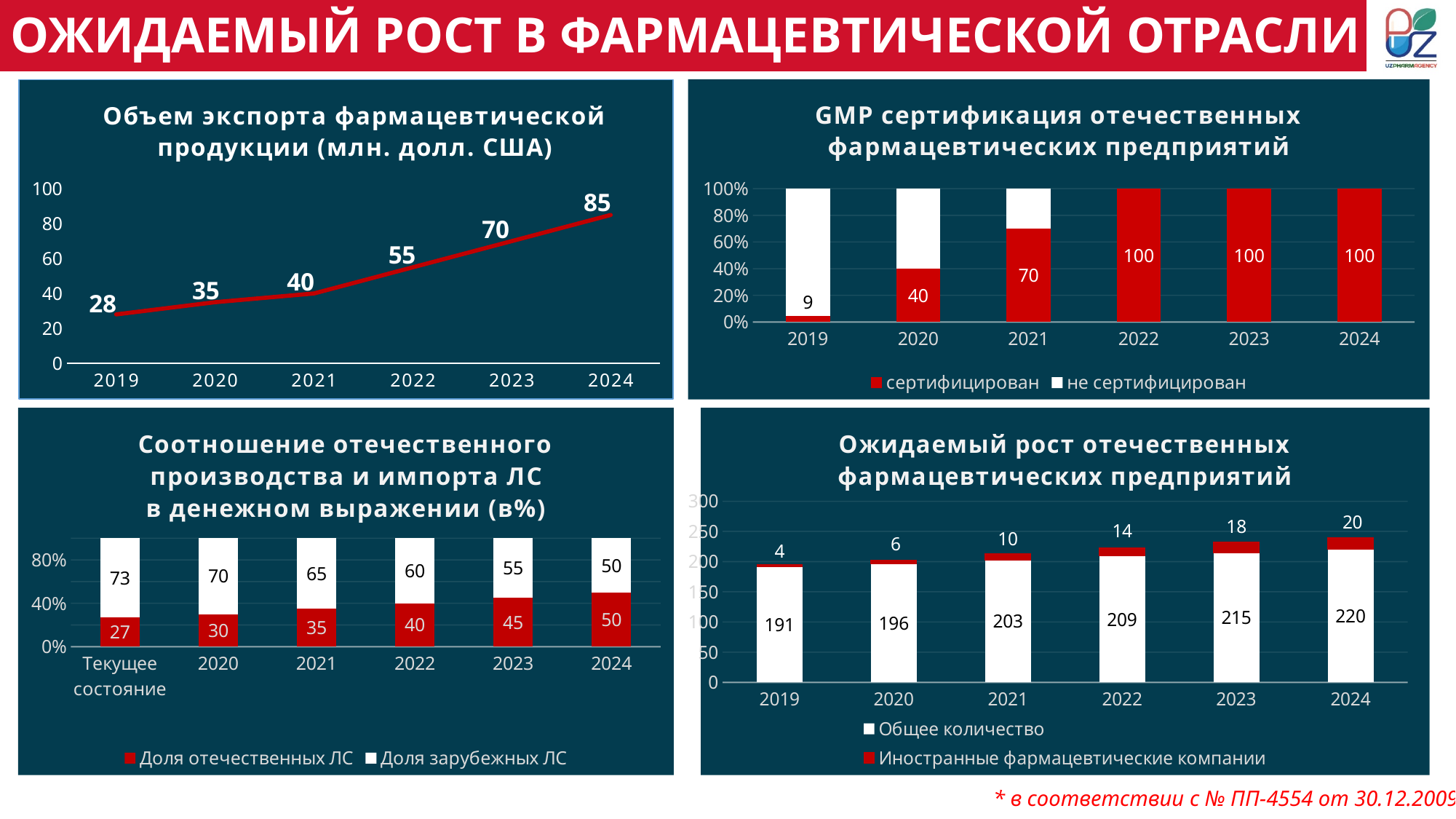
In the chart 'Объем экспорта фармацевтической продукции (млн. долл. США)', what is the difference between the 2024 and 2019 values? 57 How many series does the legend of the chart 'GMP сертификация отечественных фармацевтических предприятий' list? 2 In the chart 'GMP сертификация отечественных фармацевтических предприятий', which year has the lowest 'сертифицирован' value? 2019 In the chart 'Соотношение отечественного производства и импорта ЛС в денежном выражении (в%)', how many categories are shown on the x axis? 6 In the chart 'Соотношение отечественного производства и импорта ЛС в денежном выражении (в%)', what is the value of 'Доля зарубежных ЛС' for 2021? 65 In the chart 'Ожидаемый рост отечественных фармацевтических предприятий', what is the total of the stacked bar for 2024? 240 In the chart 'Объем экспорта фармацевтической продукции (млн. долл. США)', what is the value for 2022? 55 In the chart 'GMP сертификация отечественных фармацевтических предприятий', what is the value of 'сертифицирован' for 2021? 70 In the chart 'Объем экспорта фармацевтической продукции (млн. долл. США)', which year has the highest value? 2024 In the chart 'Объем экспорта фармацевтической продукции (млн. долл. США)', do the values rise or fall from 2019 to 2024? rise What kind of chart is 'Объем экспорта фармацевтической продукции (млн. долл. США)'? line chart In the chart 'Ожидаемый рост отечественных фармацевтических предприятий', which is larger: 'Общее количество' for 2020 or for 2023? 2023